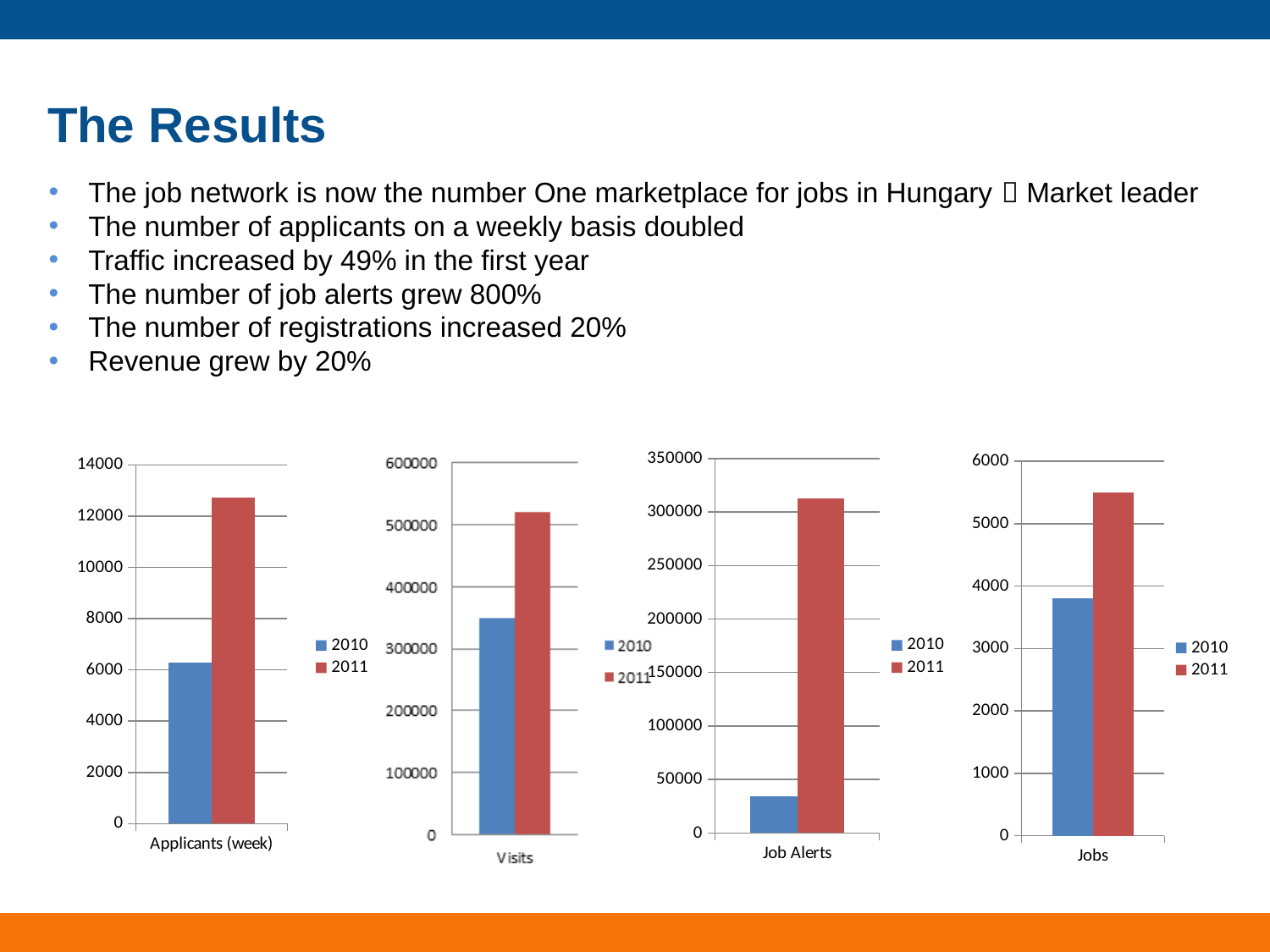
How many series does the legend of the Visits chart list? 2 How many bar charts are shown on the slide? 4 In the Visits chart, is the value for 2011 greater or less than 500000? greater In the Jobs chart, is the value for 2011 greater or less than 5000? greater In the Applicants (week) chart, which series has the larger value, 2010 or 2011? 2011 In the Visits chart, is the value for 2010 greater or less than 400000? less What kind of chart is the Applicants (week) chart? bar chart In the Jobs chart, which series has the larger value, 2010 or 2011? 2011